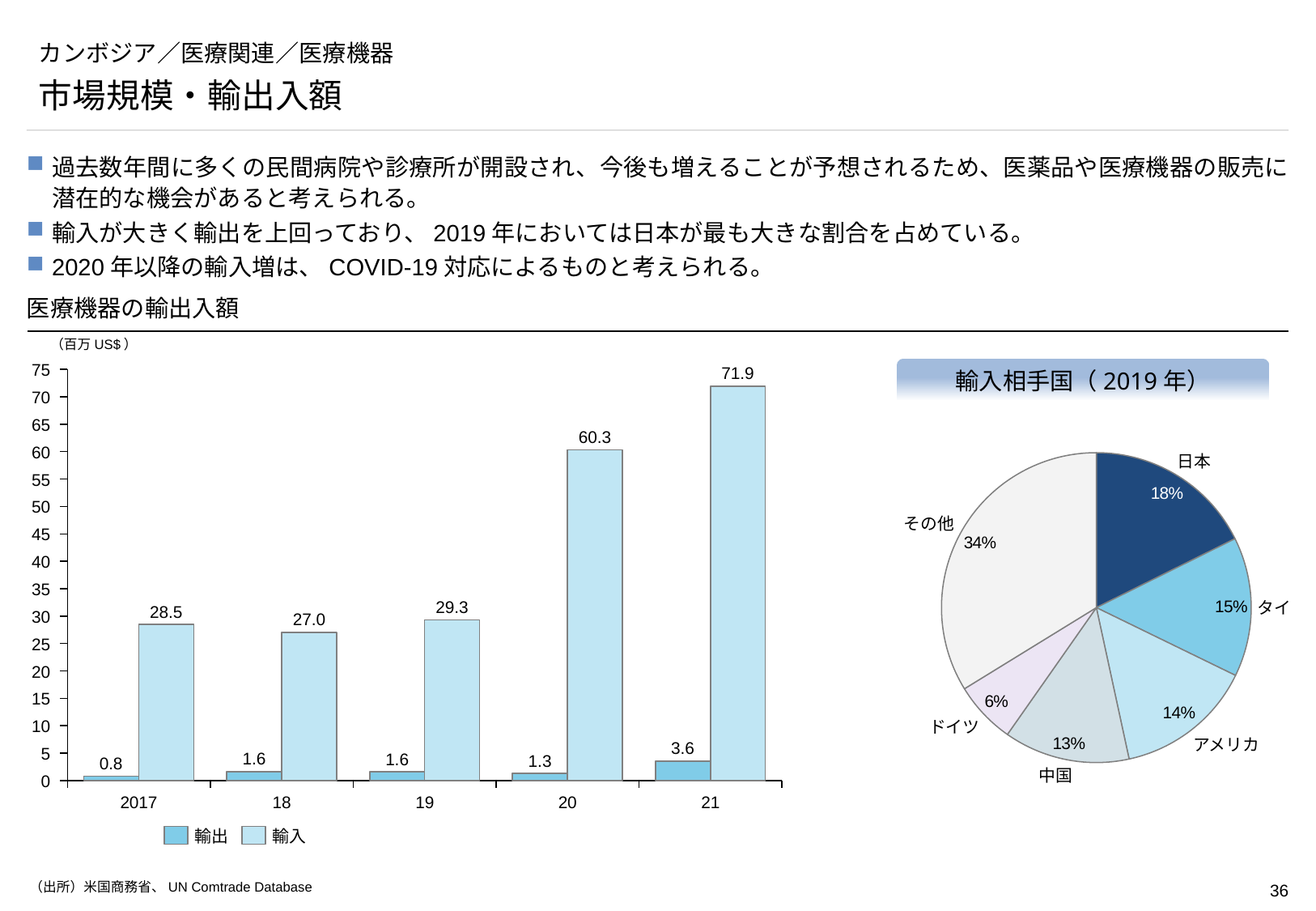
In the bar chart 医療機器の輸出入額, which year has the lowest 輸出 value? 2017 In the bar chart 医療機器の輸出入額, do the 輸入 values rise or fall from 2019 to 2021? rise In the bar chart 医療機器の輸出入額, what is the difference between the 輸入 values for 2020 and 2019? 31.0 In the pie chart 輸入相手国（2019年）, which named country (excluding その他) has the smallest share? ドイツ In the bar chart 医療機器の輸出入額, which is larger, the 輸入 value for 2017 or for 2018? 2017 What kind of chart is the chart on the right of the slide, 輸入相手国（2019年）? pie chart In the bar chart 医療機器の輸出入額, what is the value of 輸入 for 2021? 71.9 In the bar chart 医療機器の輸出入額, how many years are shown on the x axis? 5 In the bar chart 医療機器の輸出入額, how many series does the legend list? 2 In the bar chart 医療機器の輸出入額, what is the value of 輸出 for 2017? 0.8 In the bar chart 医療機器の輸出入額, which year has the highest 輸入 value? 21 In the pie chart 輸入相手国（2019年）, what share does 日本 have? 18%